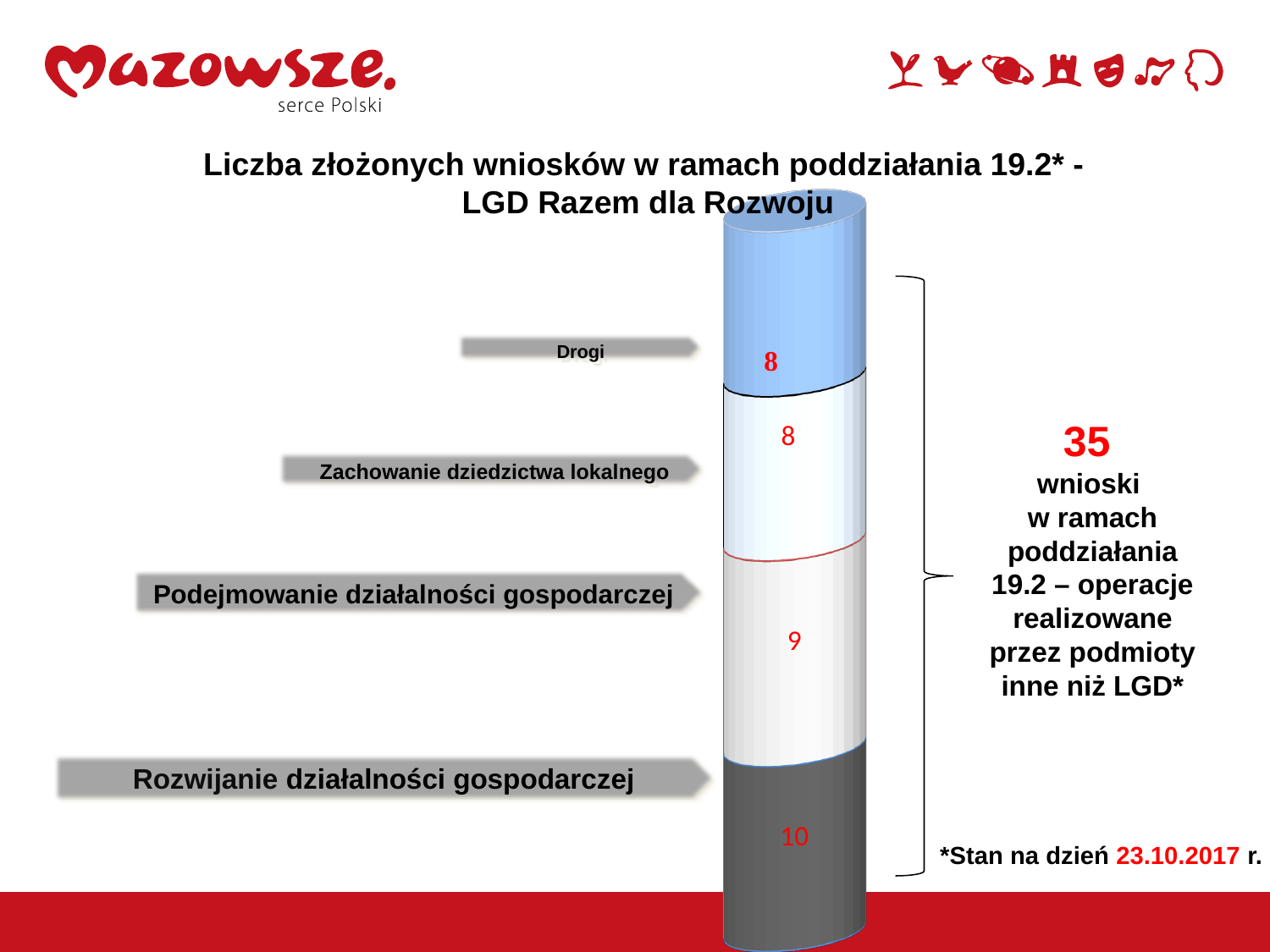
What is the total of all segments in the stacked bar? 35 What is the value for Zachowanie dziedzictwa lokalnego? 8 How many categories are shown in the chart? 4 What is the difference between the values for Rozwijanie działalności gospodarczej and Drogi? 2 Which category has the highest value? Rozwijanie działalności gospodarczej What is the value for Drogi? 8 Which is larger, the value for Rozwijanie działalności gospodarczej or the value for Podejmowanie działalności gospodarczej? Rozwijanie działalności gospodarczej What is the value for Podejmowanie działalności gospodarczej? 9 What is the difference between the values for Podejmowanie działalności gospodarczej and Zachowanie dziedzictwa lokalnego? 1 What kind of chart is shown on the slide? Stacked bar chart What is the value for Rozwijanie działalności gospodarczej? 10 What is the title of the chart? Liczba złożonych wniosków w ramach poddziałania 19.2* - LGD Razem dla Rozwoju